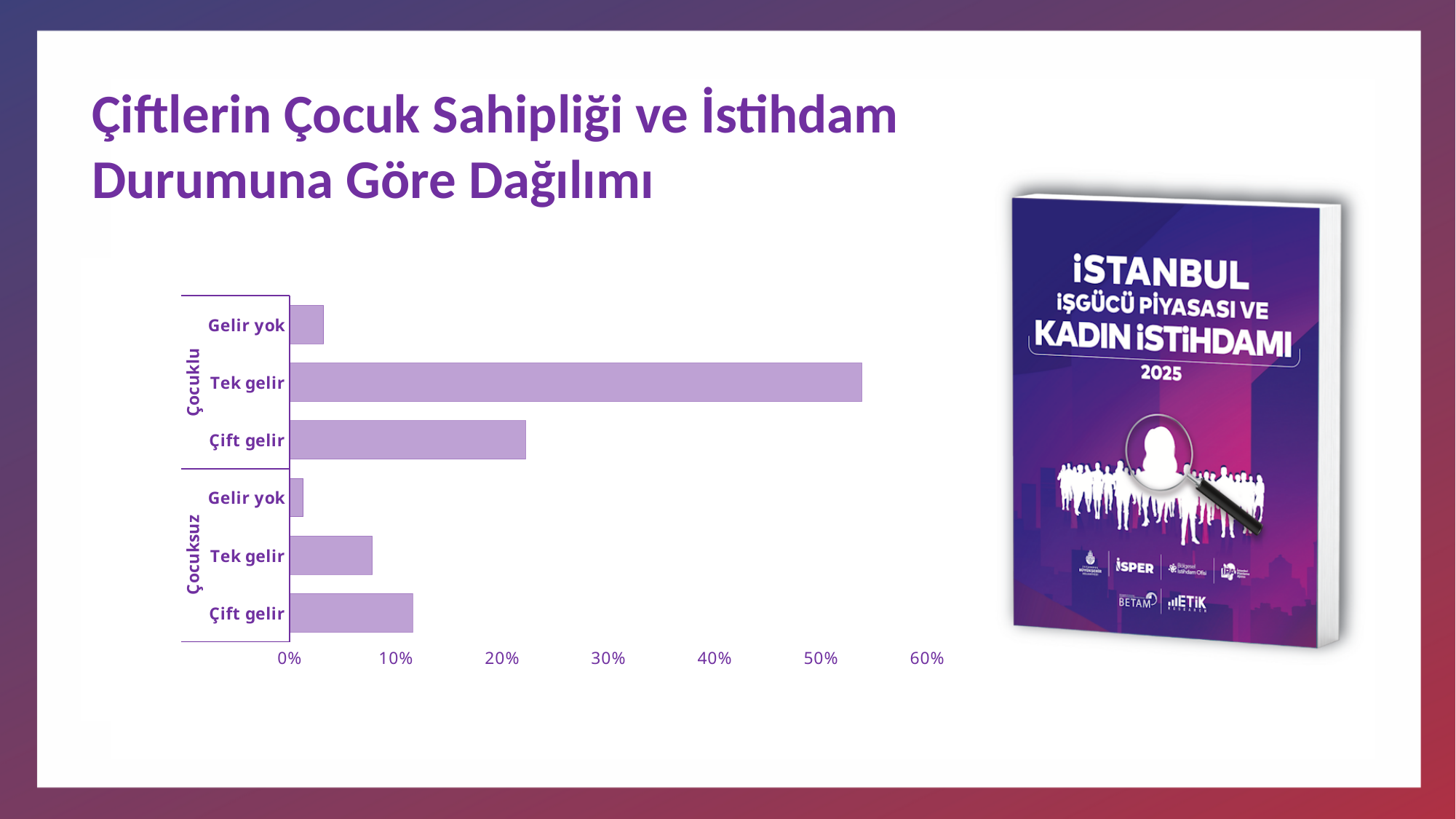
Is the value for Çocuksuz – Tek gelir greater or less than 10%? less Which bar is the longest in the chart? Çocuklu – Tek gelir Within the Çocuksuz group, which is larger: Tek gelir or Çift gelir? Çift gelir Which is larger: Çift gelir for Çocuklu or Çift gelir for Çocuksuz? Çocuklu Is the value for Çocuklu – Gelir yok greater or less than 10%? less Which bar is the shortest in the chart? Çocuksuz – Gelir yok What kind of chart is shown on the slide? bar chart How many bars does the chart show? 6 Is the value for Çocuksuz – Çift gelir greater or less than 10%? greater What is the title of the slide containing the chart? Çiftlerin Çocuk Sahipliği ve İstihdam Durumuna Göre Dağılımı